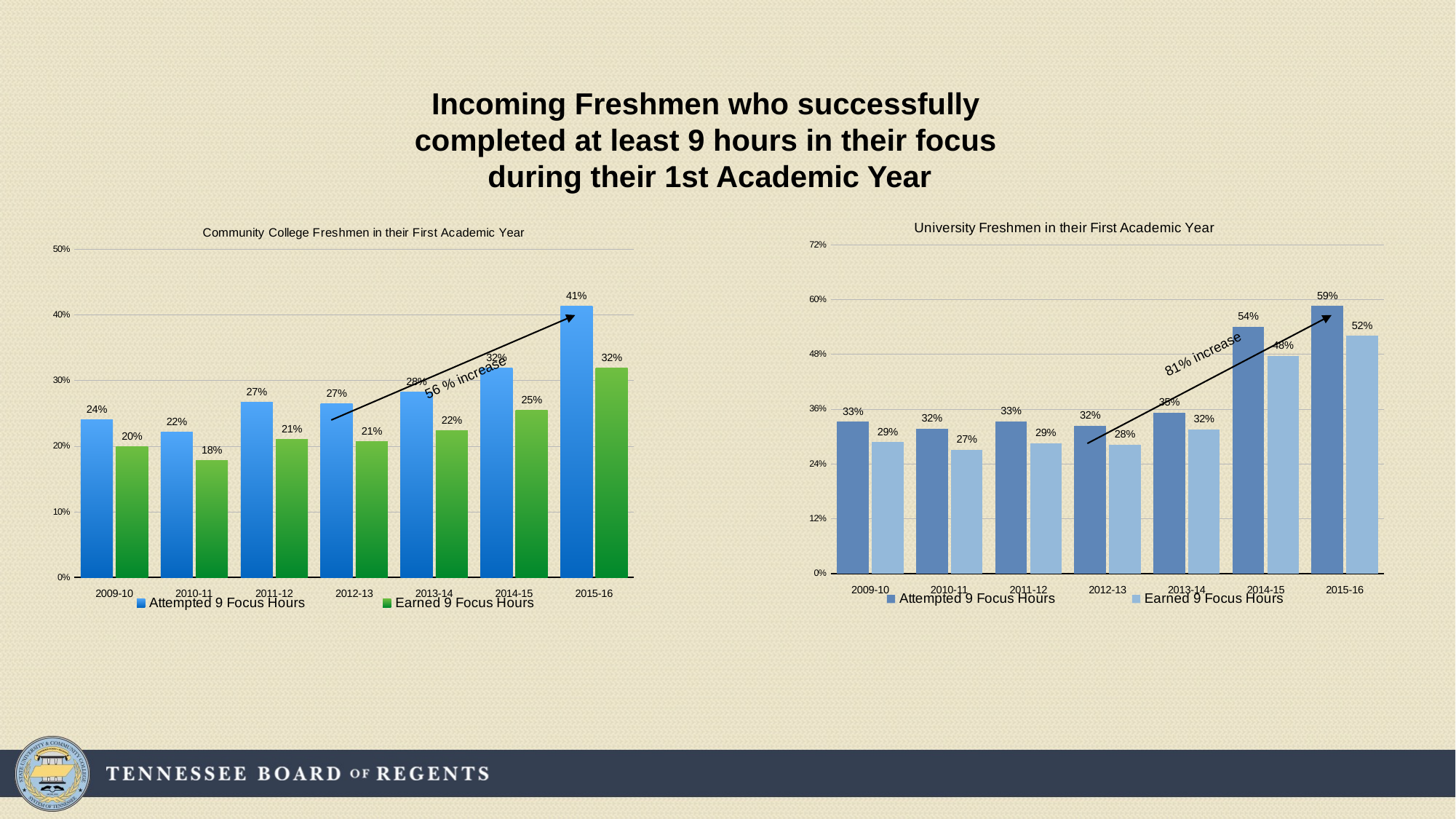
In the Community College Freshmen chart, which year has the lowest value for Earned 9 Focus Hours? 2010-11 In the University Freshmen chart, what is the value for Earned 9 Focus Hours in 2015-16? 52% In the University Freshmen chart, is the value for Earned 9 Focus Hours in 2010-11 larger or smaller than in 2009-10? smaller How many series does the legend of the University Freshmen chart list? 2 In the University Freshmen chart, what is the difference between Attempted 9 Focus Hours in 2015-16 and in 2009-10? 26% In the University Freshmen chart, which year has the highest value for Attempted 9 Focus Hours? 2015-16 How many years are shown on the x axis of the Community College Freshmen chart? 7 In the University Freshmen chart, what is the value for Attempted 9 Focus Hours in 2014-15? 54% In the Community College Freshmen chart, what is the value for Attempted 9 Focus Hours in 2015-16? 41% What type of chart is the Community College Freshmen in their First Academic Year chart? bar chart In the Community College Freshmen chart, what is the difference between Attempted and Earned 9 Focus Hours in 2015-16? 9% In the Community College Freshmen chart, what is the value for Earned 9 Focus Hours in 2010-11? 18%